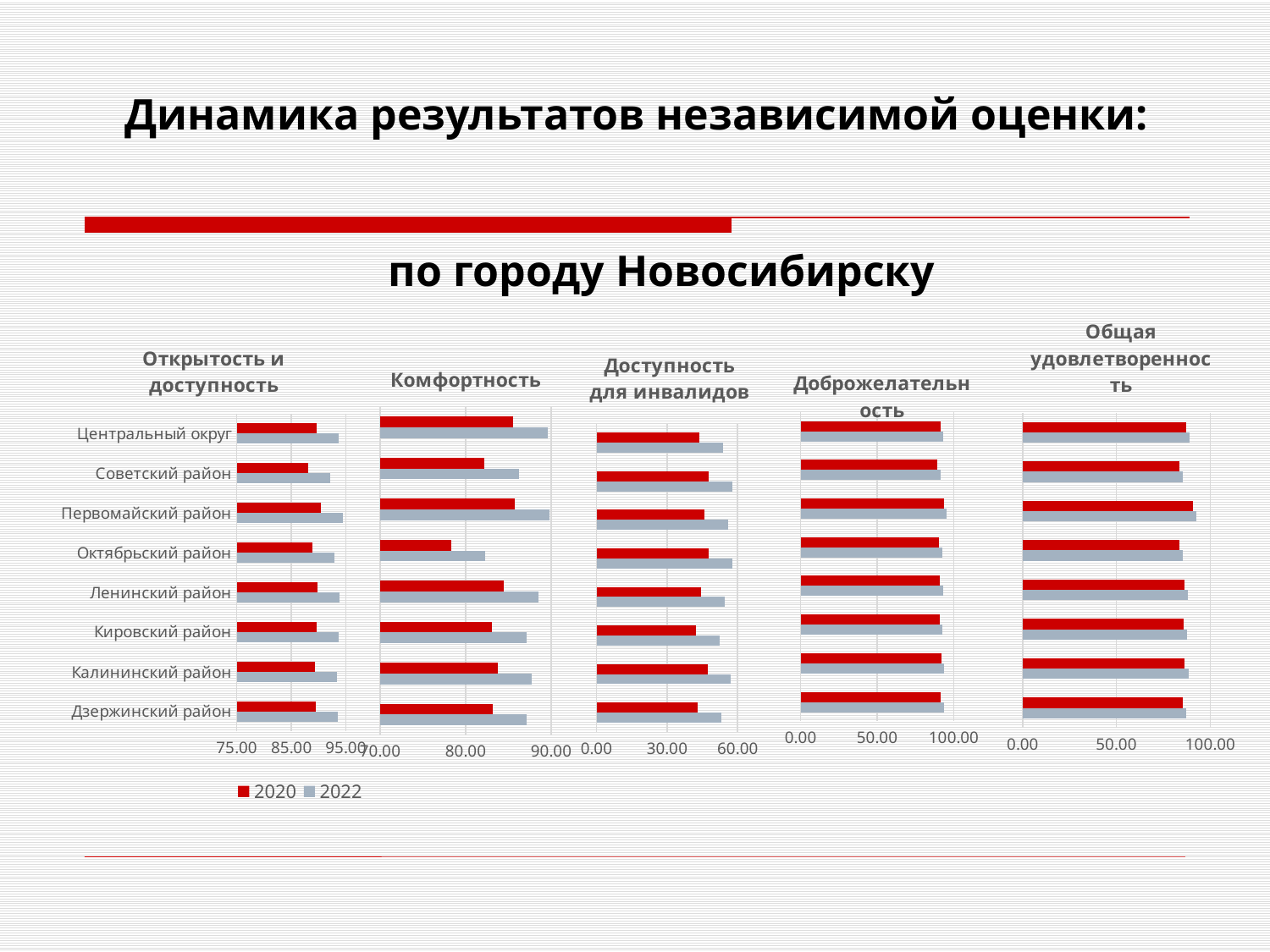
How many charts are shown on the slide? 5 In the "Доступность для инвалидов" chart, is the 2020 value for Центральный округ greater or less than 30.00? greater How many series does the legend list? 2 In the "Комфортность" chart, which district has the lowest 2020 value? Октябрьский район In the "Комфортность" chart, which 2020 value is larger: Центральный округ or Октябрьский район? Центральный округ In the "Комфортность" chart, which is larger for Центральный округ: the 2020 value or the 2022 value? 2022 In the "Доброжелательность" chart, is the 2022 value for Ленинский район greater or less than 50.00? greater In the "Комфортность" chart, is the 2020 value for Октябрьский район greater or less than 80.00? less How many districts are listed on the "Открытость и доступность" chart? 8 Which colour represents the 2020 series in the legend? red What kind of chart is used for "Комфортность"? bar chart